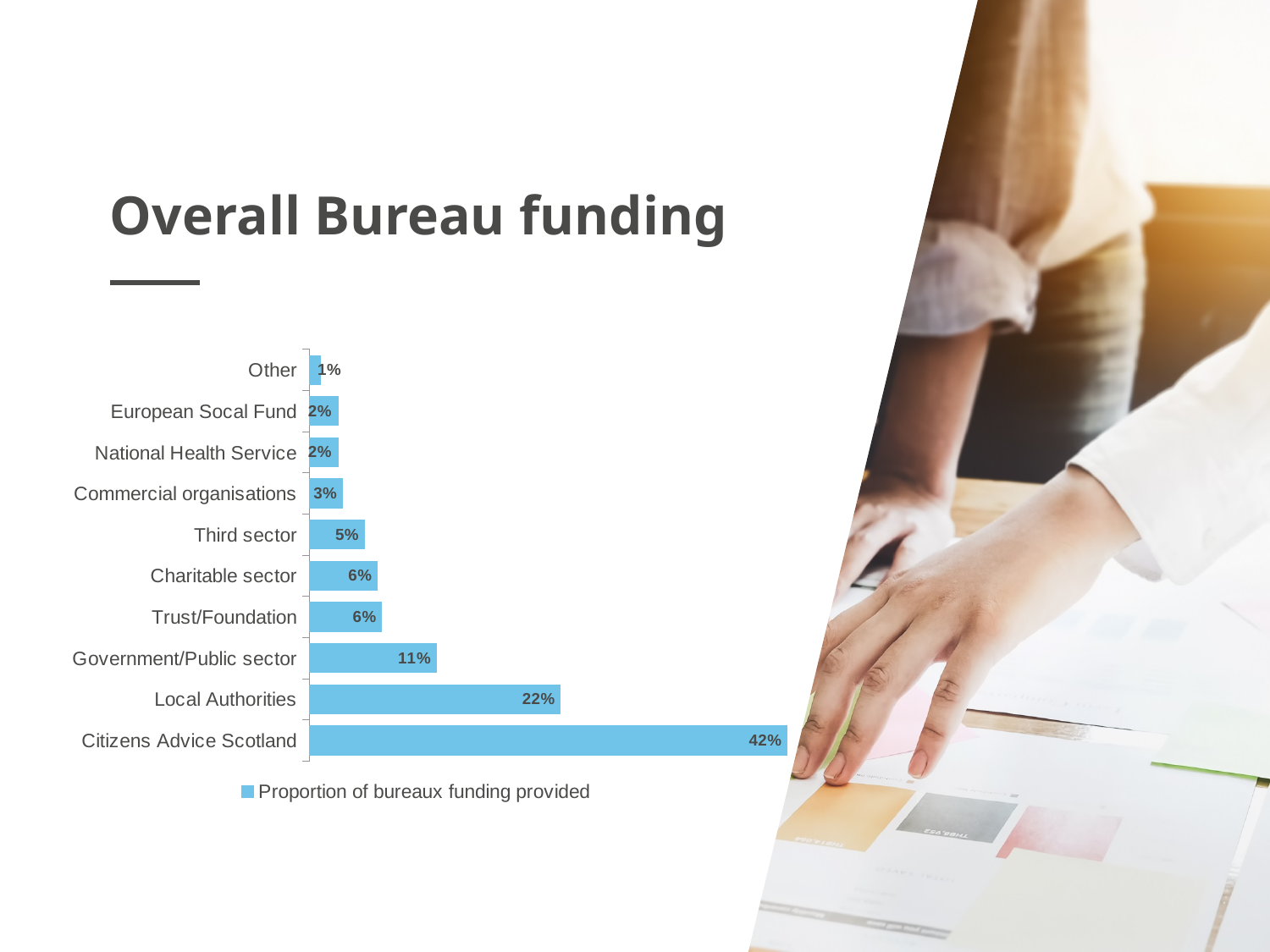
What is the difference between the proportion of funding from Citizens Advice Scotland and from Local Authorities? 20% Which funding source provides the highest proportion of bureaux funding? Citizens Advice Scotland What proportion of bureaux funding is provided by Government/Public sector? 11% How many funding sources are shown in the chart? 10 What proportion of bureaux funding is provided by Local Authorities? 22% Which provides a larger proportion of bureaux funding, Government/Public sector or Trust/Foundation? Government/Public sector What proportion of bureaux funding is provided by Citizens Advice Scotland? 42% What is the legend entry for the series in the chart? Proportion of bureaux funding provided What proportion of bureaux funding is provided by Third sector? 5% Which funding source provides the lowest proportion of bureaux funding? Other How many series does the chart legend list? 1 What kind of chart is shown on the slide? Bar chart